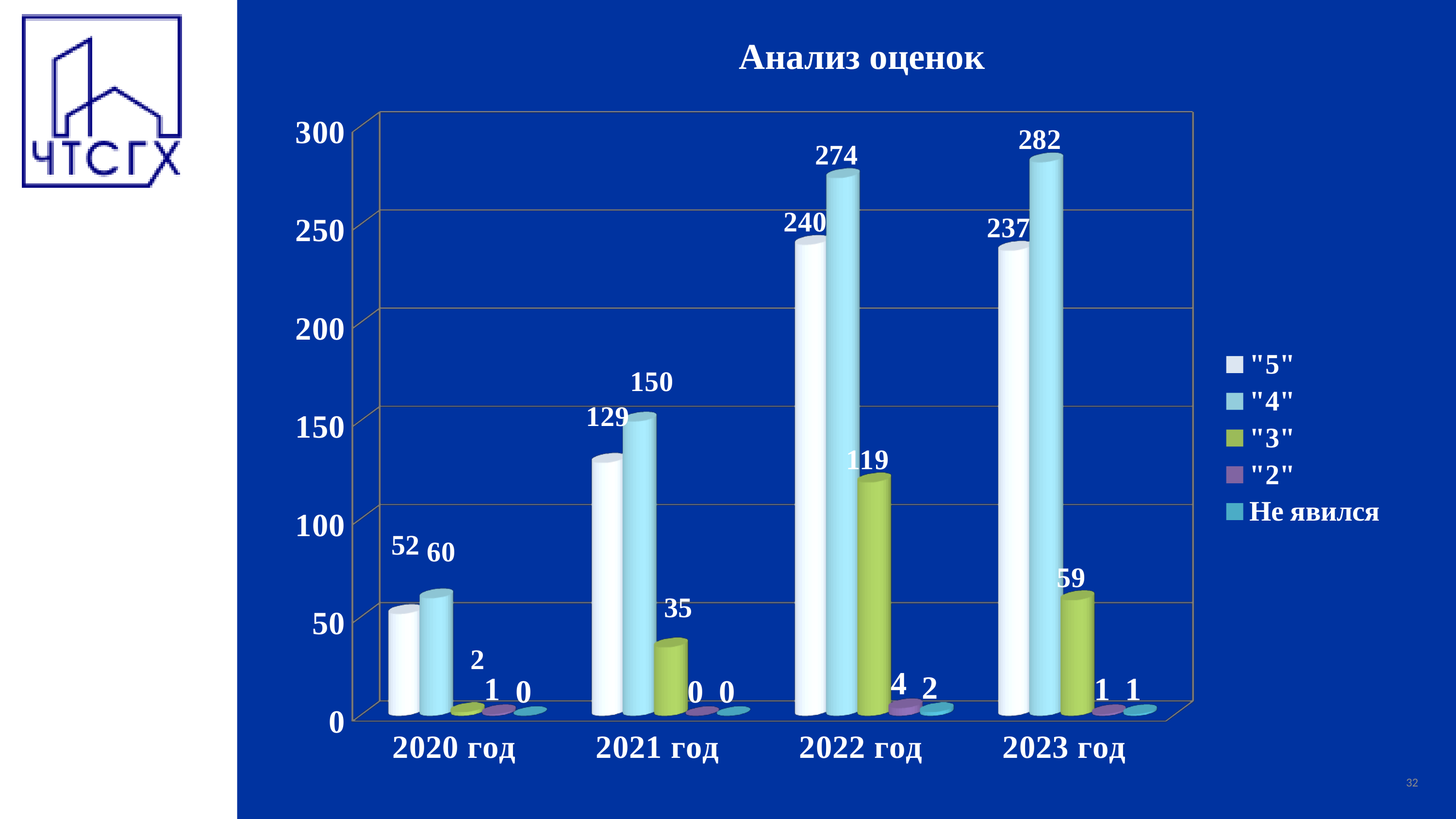
In which year is the value for "5" the lowest? 2020 год How many years are shown on the x axis? 4 What is the difference between the "4" and "5" values in 2023 год? 45 What is the value for "2" in 2022 год? 4 What kind of chart is shown on the slide? Bar chart What is the title of the chart? Анализ оценок Which is larger in 2022 год: the value for "5" or the value for "3"? "5" In which year is the value for "4" the highest? 2023 год What is the value for "4" in 2022 год? 274 How many series does the legend list? 5 What is the value for "5" in 2021 год? 129 What is the value for "3" in 2023 год? 59